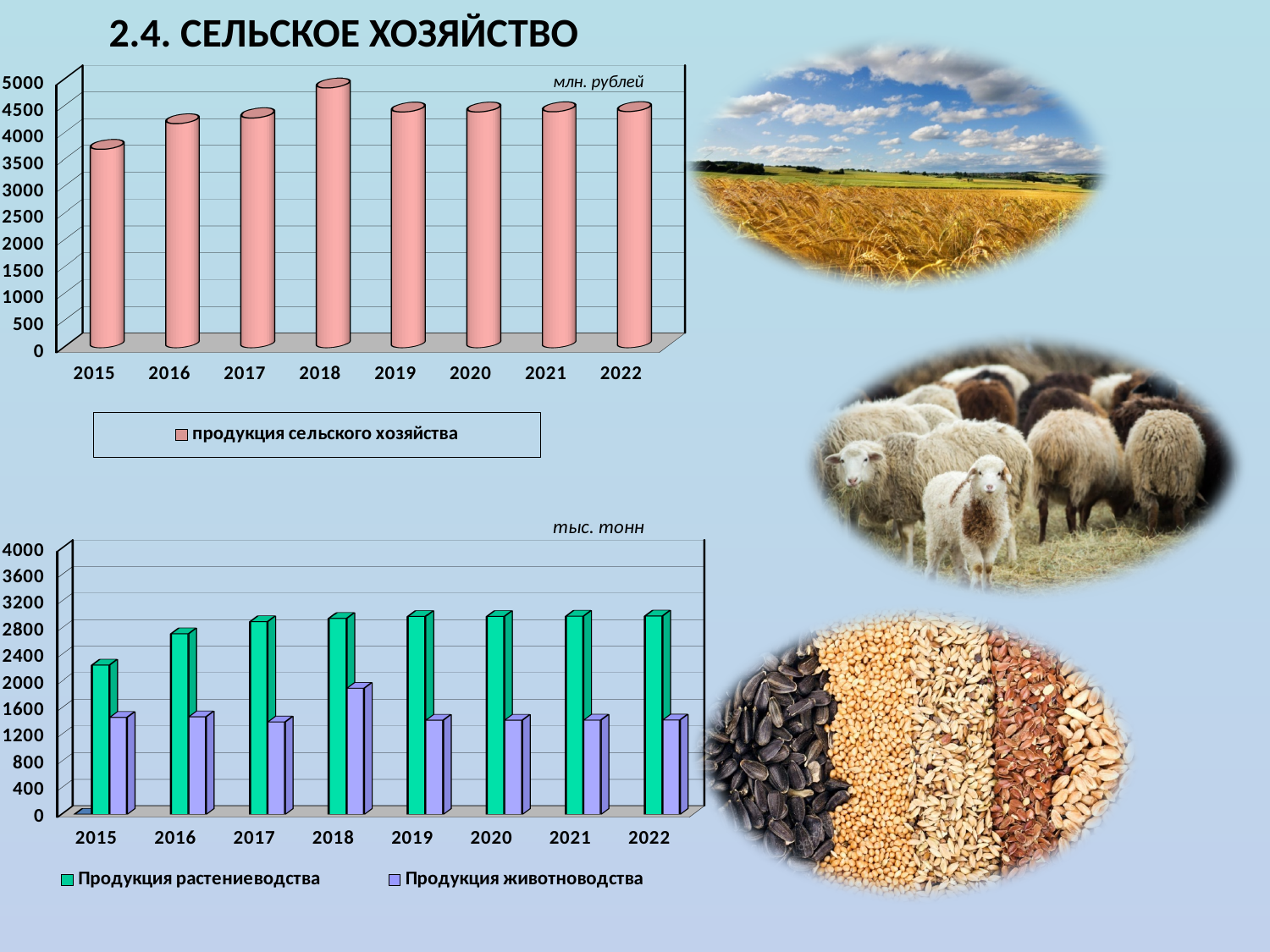
In the bottom chart (тыс. тонн), is the value of Продукция растениеводства for 2015 greater or less than 2400? less In the top chart (млн. рублей), is the value for 2018 greater or less than 4500? greater In the bottom chart (тыс. тонн), how many series does the legend list? 2 In the bottom chart (тыс. тонн), does Продукция растениеводства generally rise or fall from 2015 to 2022? rise In the top chart (млн. рублей), which year has the highest value? 2018 In the bottom chart (тыс. тонн), which series is larger in 2018: Продукция растениеводства or Продукция животноводства? Продукция растениеводства In the top chart (млн. рублей), is the value for 2015 greater or less than 4000? less In the bottom chart (тыс. тонн), in which year is Продукция животноводства highest? 2018 In the top chart (млн. рублей), which year has the lowest value? 2015 In the top chart, what unit is indicated in the upper right corner of the plot area? млн. рублей In the top chart (млн. рублей), how many years are shown on the x axis? 8 What kind of chart is the top chart on the slide (млн. рублей)? bar chart